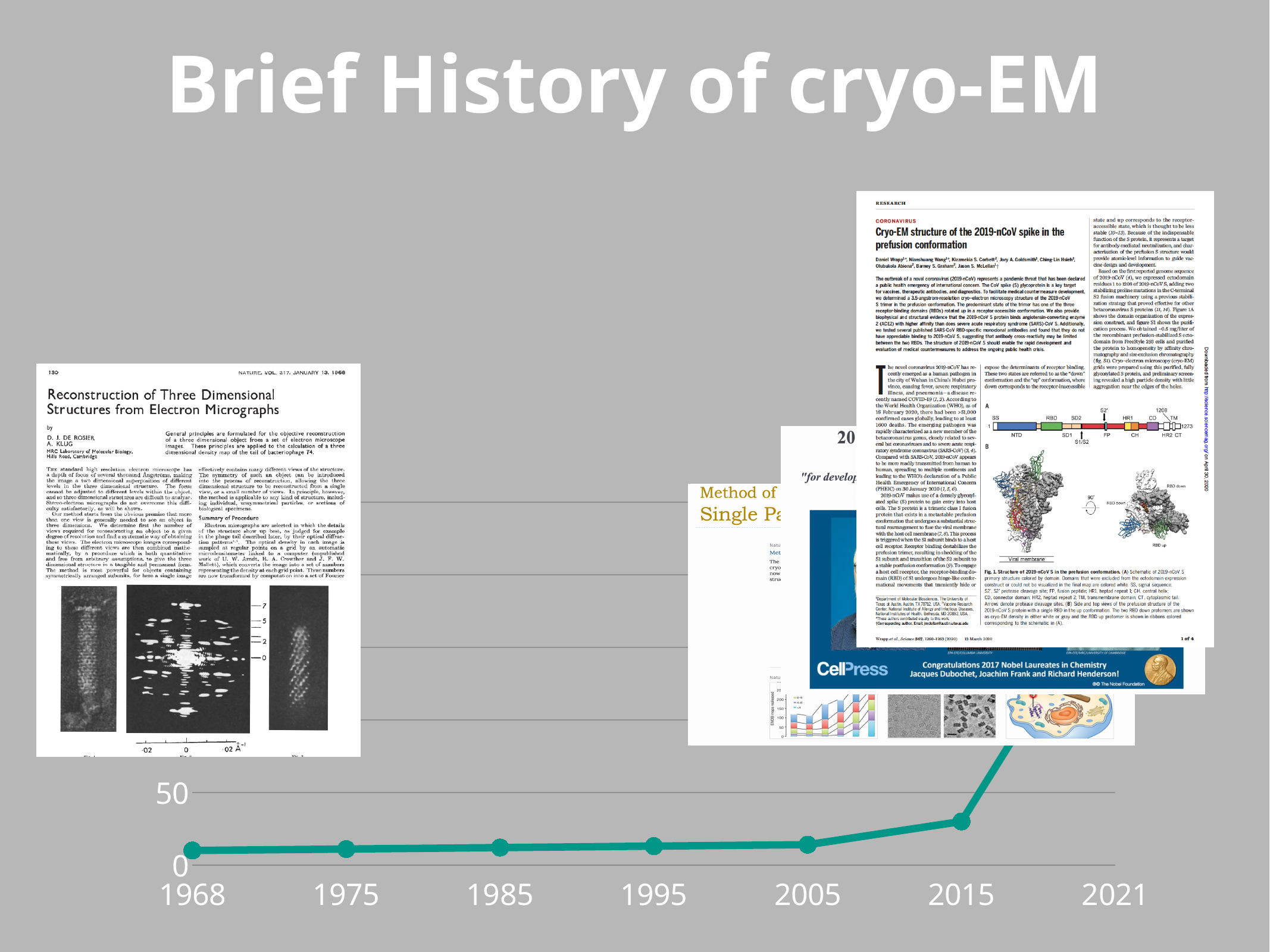
How many years are labelled on the x axis of the chart? 7 Do the values generally rise or fall from 1968 to the right end of the x axis? rise Is the value for 2015 greater or less than 50? less Is the value for 1985 greater or less than 50? less What is the first year labelled on the x axis? 1968 What is the title of the slide containing the chart? Brief History of cryo-EM Is the value for 2005 greater or less than 50? less After which labelled year does the line begin to rise sharply? 2015 What kind of chart is shown on the slide? line chart Which has the larger value, 1968 or 2015? 2015